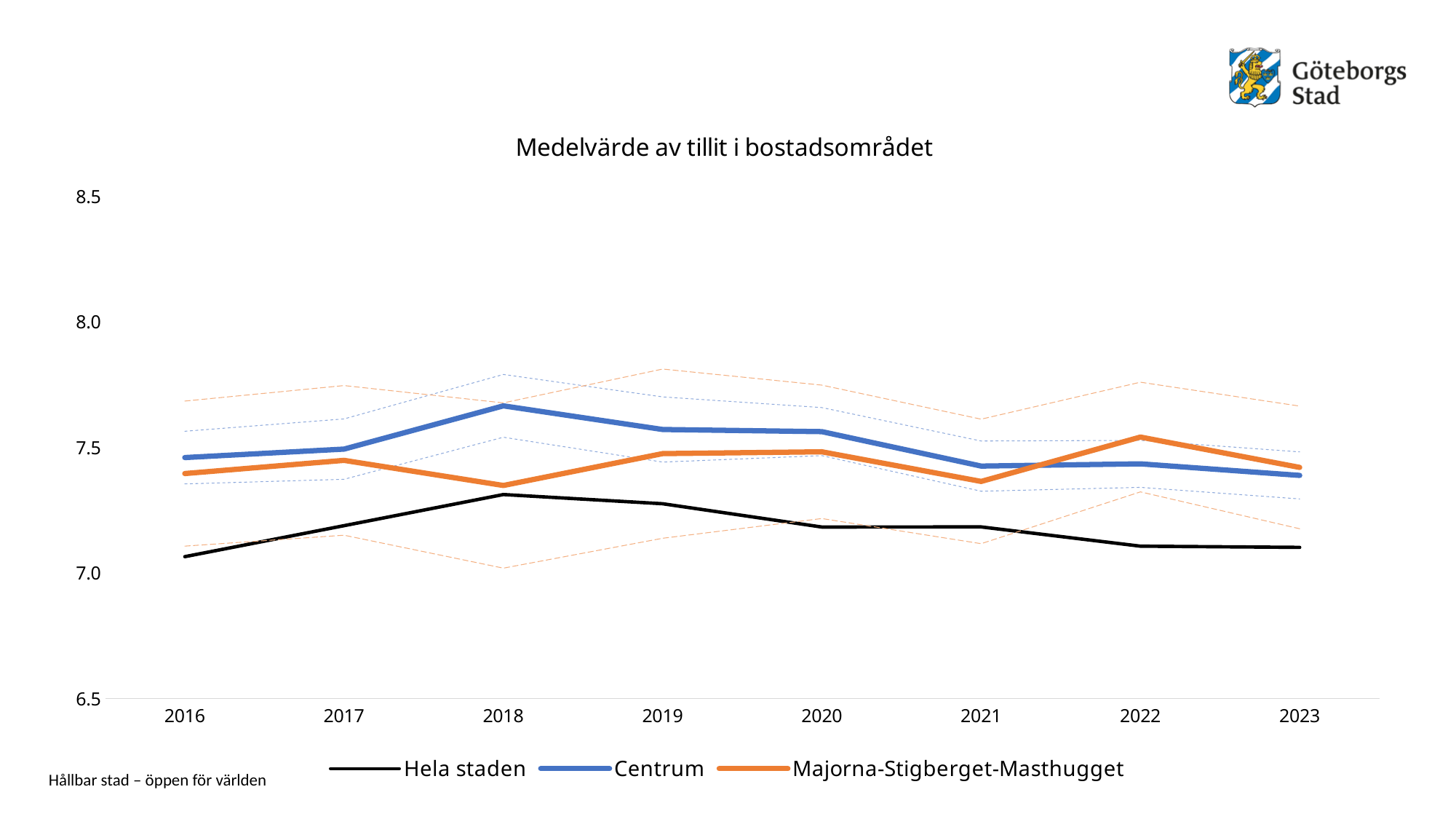
What is the title of the chart? Medelvärde av tillit i bostadsområdet In which year does Centrum reach its highest value? 2018 Which series is drawn in orange? Majorna-Stigberget-Masthugget Is the value for Hela staden in 2018 greater or less than 7.5? less Is the value for Centrum in 2018 greater or less than 7.5? greater What kind of chart is shown on the slide? line chart In which year does Majorna-Stigberget-Masthugget reach its highest value? 2022 How many years are shown on the x axis? 8 Does the value for Hela staden rise or fall from 2018 to 2022? fall How many series does the legend list? 3 In 2018, which is higher: Centrum or Majorna-Stigberget-Masthugget? Centrum Is the value for Hela staden in 2022 greater or less than 7.5? less